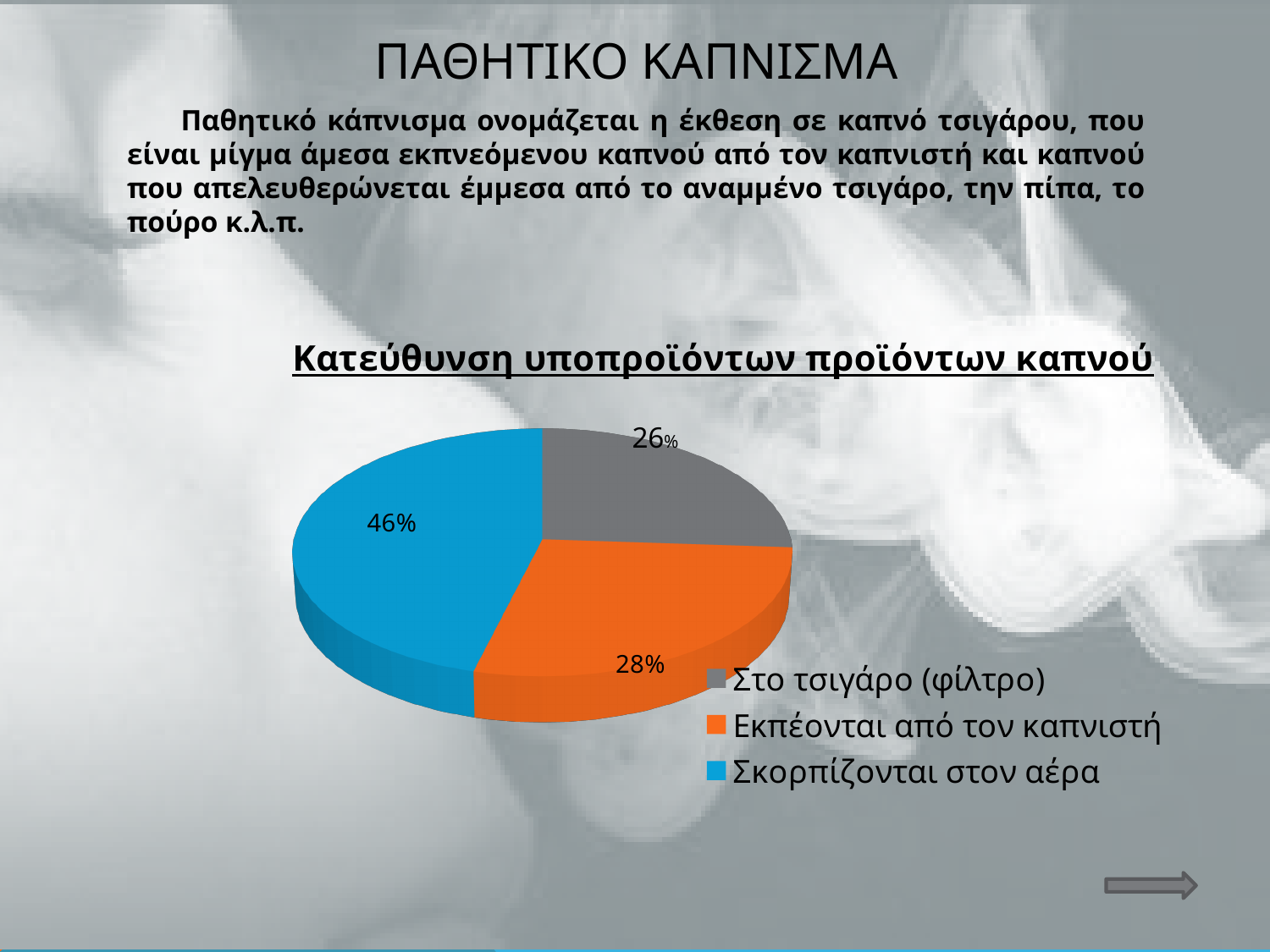
What percentage of tobacco by-products is shown for 'Σκορπίζονται στον αέρα'? 46% What percentage is shown for 'Στο τσιγάρο (φίλτρο)'? 26% What is the title of the chart? Κατεύθυνση υποπροϊόντων προϊόντων καπνού What percentage is shown for 'Εκπέονται από τον καπνιστή'? 28% What kind of chart is shown on the slide? pie chart Which category has the smallest share of the pie? Στο τσιγάρο (φίλτρο) What colour is the slice for 'Εκπέονται από τον καπνιστή'? orange How many slices does the pie chart have? 3 Which is larger: the share for 'Σκορπίζονται στον αέρα' or the share for 'Εκπέονται από τον καπνιστή'? Σκορπίζονται στον αέρα Which category has the largest share of the pie? Σκορπίζονται στον αέρα What is the difference in percentage points between 'Σκορπίζονται στον αέρα' and 'Στο τσιγάρο (φίλτρο)'? 20 What is the difference in percentage points between 'Εκπέονται από τον καπνιστή' and 'Στο τσιγάρο (φίλτρο)'? 2